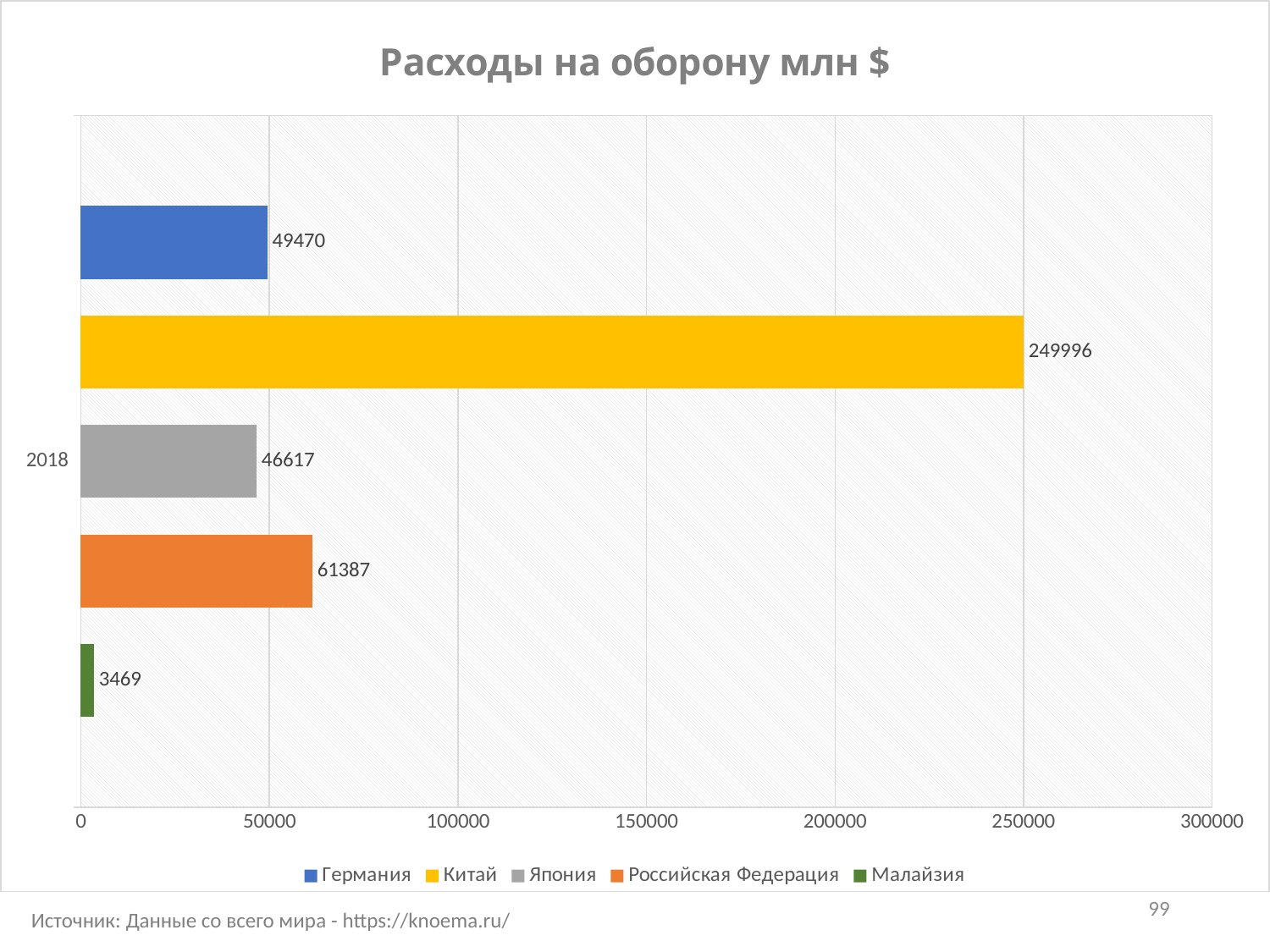
What is the difference between the values for Российская Федерация and Япония? 14770 How many series does the legend list? 5 What is the title of the chart? Расходы на оборону млн $ What is the defence spending value for Китай (China) in 2018? 249996 Is the value for Российская Федерация greater or less than 50000? greater Which is larger, the value for Германия or the value for Япония? Германия What kind of chart is shown on the slide? Bar chart Which country has the highest defence spending on the chart? Китай Which country has the lowest defence spending on the chart? Малайзия What is the value shown for Германия (Germany)? 49470 What is the value shown for Российская Федерация (Russian Federation)? 61387 What is the value shown for Малайзия (Malaysia)? 3469